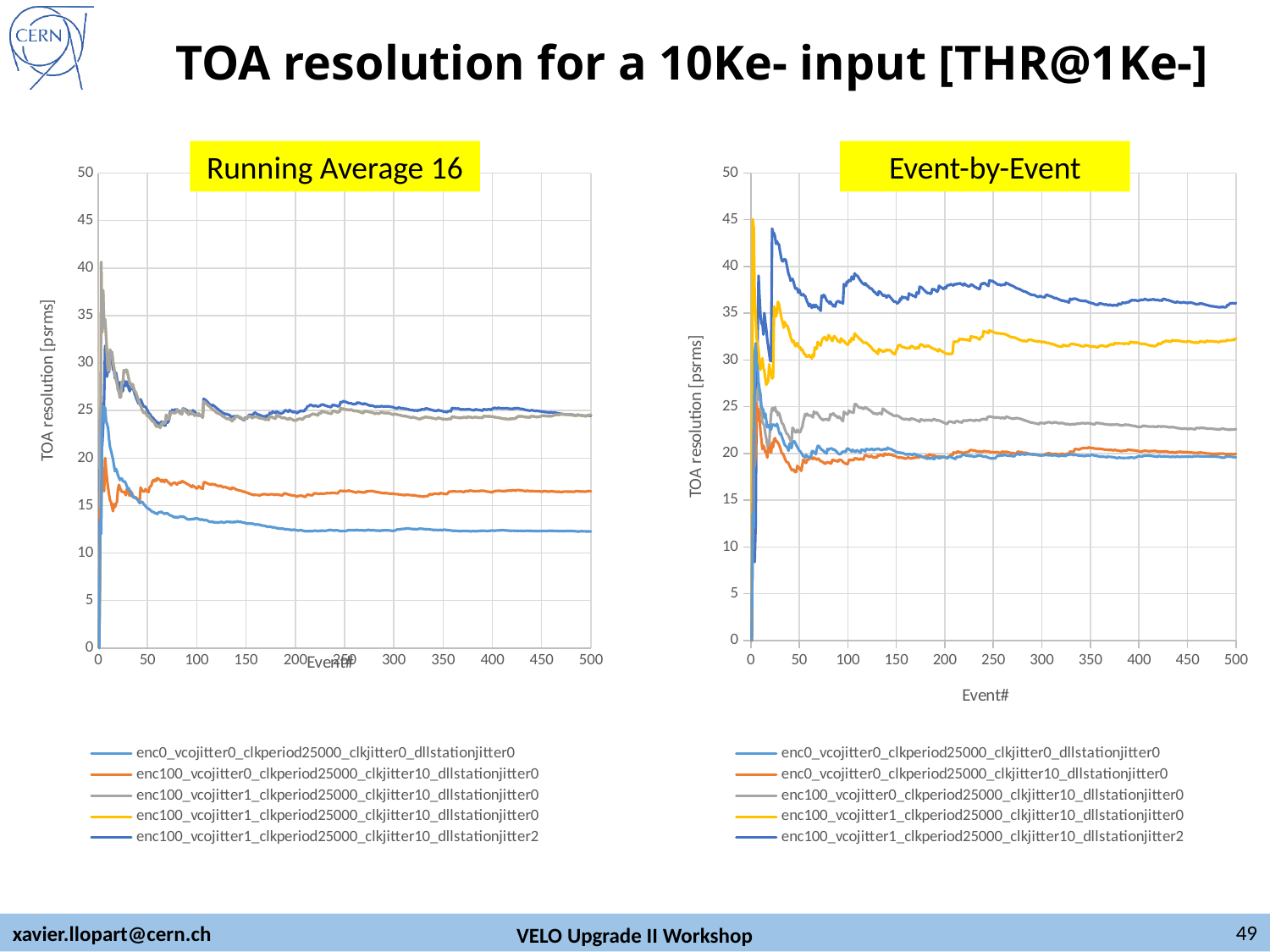
In the 'Event-by-Event' chart, is the value of the enc100_vcojitter0_clkperiod25000_clkjitter10_dllstationjitter0 series at Event# 500 greater or less than 25? less In the 'Running Average 16' chart, is the value of the enc100_vcojitter0_clkperiod25000_clkjitter10_dllstationjitter0 series at Event# 500 greater or less than 20? less How many series does the legend of the 'Event-by-Event' chart list? 5 In the 'Running Average 16' chart, is the value of the enc0_vcojitter0_clkperiod25000_clkjitter0_dllstationjitter0 series at Event# 500 greater or less than 15? less What is the y-axis label of the 'Event-by-Event' chart? TOA resolution [psrms] What kind of chart is the 'Running Average 16' chart? line chart What is the maximum value shown on the y-axis of the 'Running Average 16' chart? 50 In the 'Running Average 16' chart, does the enc0_vcojitter0_clkperiod25000_clkjitter0_dllstationjitter0 series rise or fall between Event# 50 and Event# 500? fall How many series does the legend of the 'Running Average 16' chart list? 5 In the 'Event-by-Event' chart, which series is higher at Event# 500: enc100_vcojitter1_clkperiod25000_clkjitter10_dllstationjitter2 or enc100_vcojitter1_clkperiod25000_clkjitter10_dllstationjitter0? enc100_vcojitter1_clkperiod25000_clkjitter10_dllstationjitter2